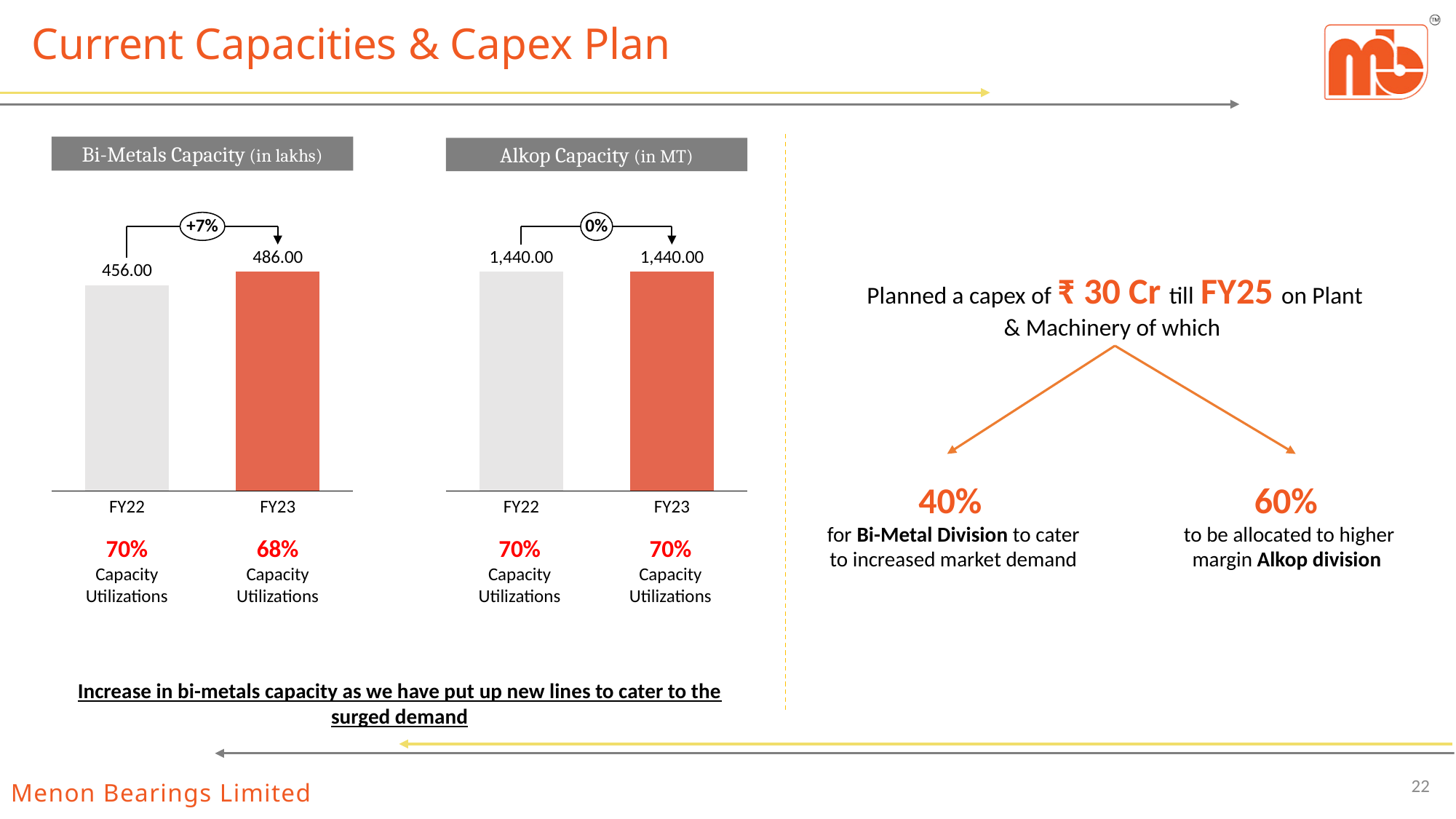
What percentage change is shown above the bars in the Bi-Metals Capacity chart? +7% In the Bi-Metals Capacity chart, do the values rise or fall from FY22 to FY23? rise In the Alkop Capacity chart, what is the difference between the FY23 and FY22 values? 0.00 What unit is given in the title of the Alkop Capacity chart? in MT In the Alkop Capacity chart, what is the value for FY22? 1,440.00 In the Bi-Metals Capacity chart, is the FY22 value larger or smaller than the FY23 value? smaller In the Bi-Metals Capacity chart, which year has the higher capacity? FY23 How many bars are shown in the Alkop Capacity chart? 2 What type of chart is the Bi-Metals Capacity chart? bar chart In the Bi-Metals Capacity chart, what is the value for FY23? 486.00 In the Bi-Metals Capacity chart, what is the difference between the FY23 and FY22 values? 30.00 In the Bi-Metals Capacity chart, what is the value for FY22? 456.00